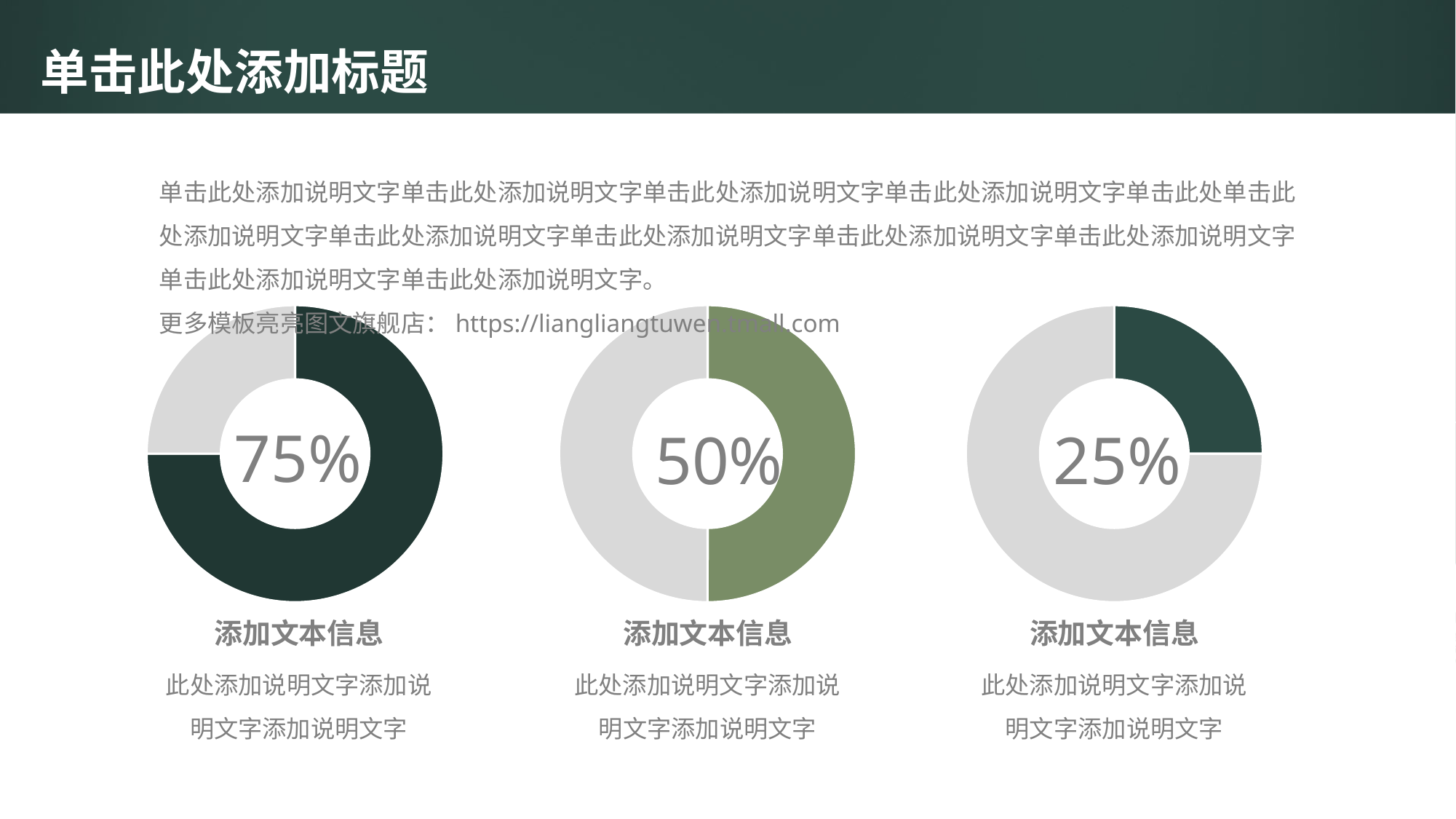
Which is larger, the percentage in the middle donut chart or the percentage in the right donut chart? Middle donut chart What is the difference between the percentage in the left donut chart and the percentage in the right donut chart? 50% What kind of chart is used for the three figures on the slide? Donut chart What colour is the filled segment of the middle donut chart? Light green Which donut chart shows the highest percentage: left, middle or right? Left What percentage is shown in the centre of the middle donut chart? 50% What percentage is shown in the centre of the left donut chart? 75% Is the percentage shown in the right donut chart greater or less than 50%? less What share of the left donut chart is filled with the dark green colour? 75% Which donut chart shows the lowest percentage: left, middle or right? Right How many donut charts are on the slide? 3 What percentage is shown in the centre of the right donut chart? 25%